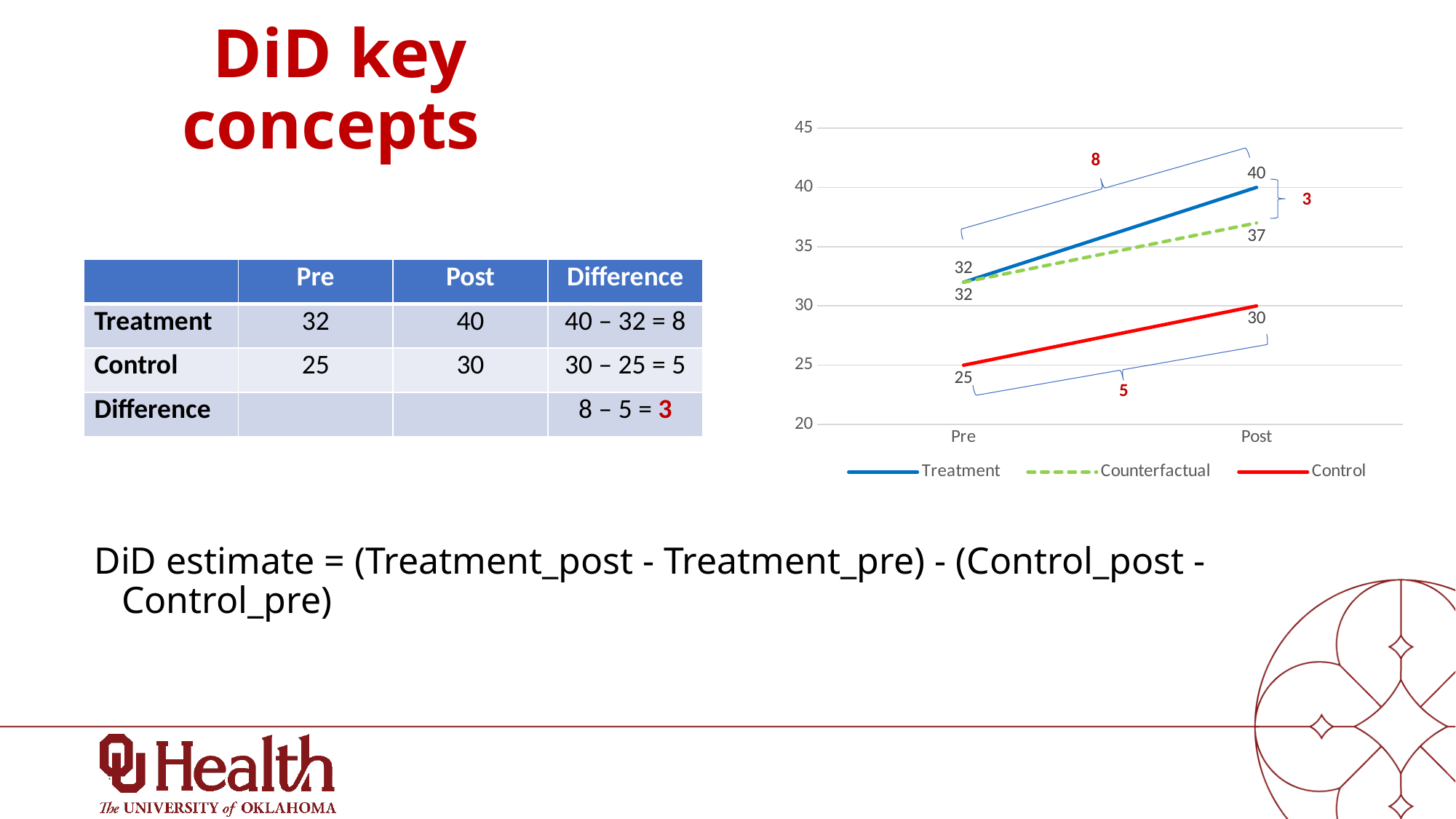
What is the value of the Treatment series at Post? 40 What kind of chart is shown on the slide? line chart How many series does the chart legend list? 3 What is the difference between the Control value at Post and at Pre? 5 What is the value of the Counterfactual series at Post? 37 Which series has the highest value at Post? Treatment Which series has the lowest value at Post? Control Which series is drawn as a dashed line in the chart? Counterfactual What is the difference between the Treatment value at Post and the Counterfactual value at Post? 3 What is the value of the Control series at Pre? 25 What is the value of the Control series at Post? 30 Does the Treatment series rise or fall from Pre to Post? rise